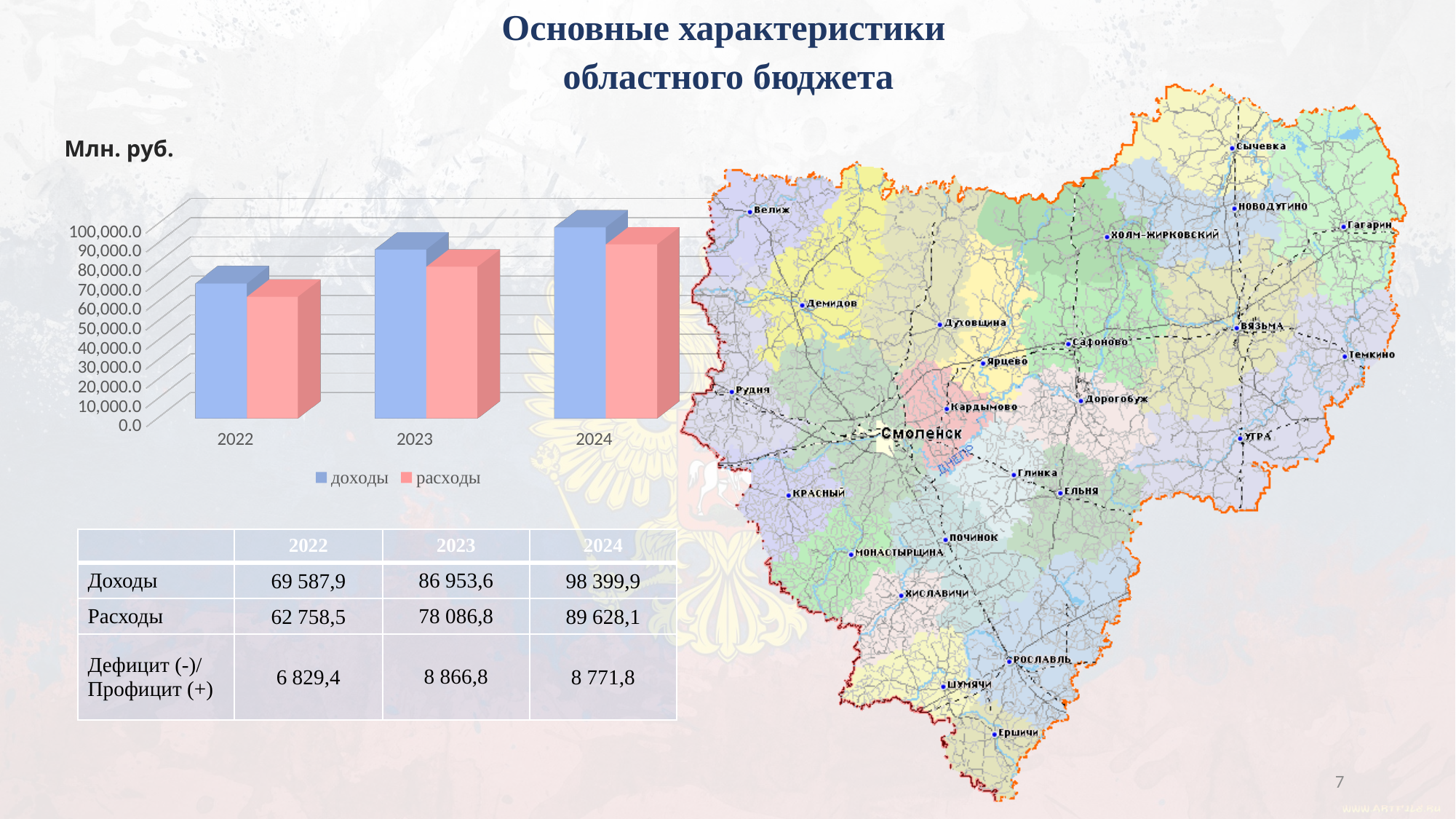
How many series does the chart legend list? 2 According to the table under the chart, what is the value of Расходы for 2022? 62 758,5 According to the table under the chart, what is the value of Доходы for 2024? 98 399,9 What unit is stated above the chart? Млн. руб. What kind of chart is shown on the slide? bar chart Which series is shown in blue in the chart? доходы How many years are shown on the x axis of the chart? 3 According to the table under the chart, what is the value of Доходы for 2023? 86 953,6 In which year is the доходы bar the highest? 2024 Do the доходы values rise or fall from 2022 to 2024? rise In which year is the расходы bar the lowest? 2022 Is the доходы value for 2022 greater or less than 60,000.0? greater